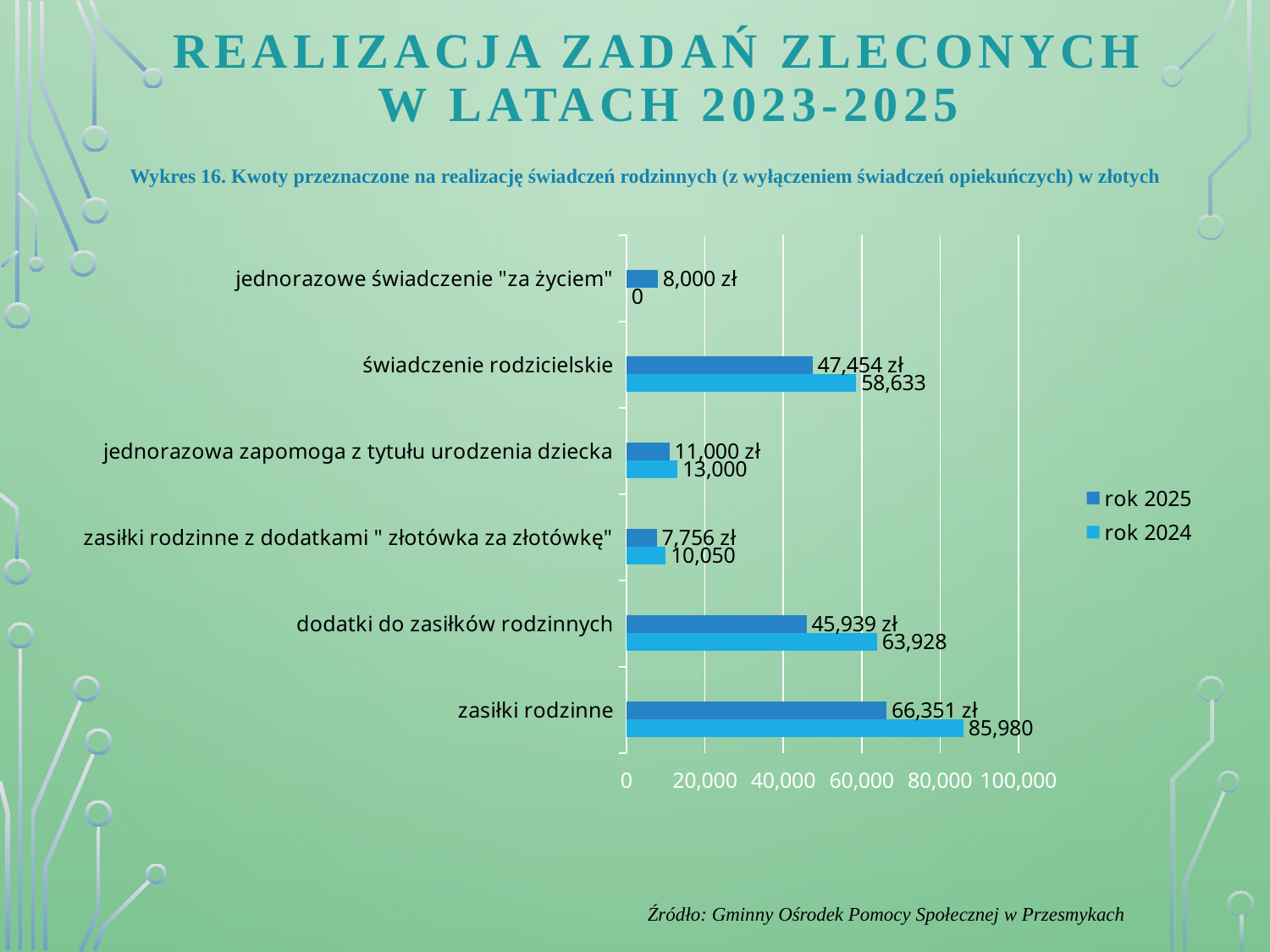
What is the difference between the rok 2024 and rok 2025 values for dodatki do zasiłków rodzinnych? 17,989 Which category has the highest value in the rok 2025 series? zasiłki rodzinne How many categories are shown on the chart? 6 What is the value for świadczenie rodzicielskie in the rok 2025 series? 47,454 zł Which is larger for jednorazowa zapomoga z tytułu urodzenia dziecka: the rok 2024 value or the rok 2025 value? rok 2024 How many series does the legend list? 2 Which category has the lowest value in the rok 2024 series? jednorazowe świadczenie "za życiem" Which series is shown in the darker blue colour? rok 2025 What kind of chart is shown on the slide? bar chart What is the value for zasiłki rodzinne in the rok 2024 series? 85,980 Is the rok 2024 value for zasiłki rodzinne greater or less than 80,000? greater What is the value for jednorazowe świadczenie "za życiem" in the rok 2024 series? 0